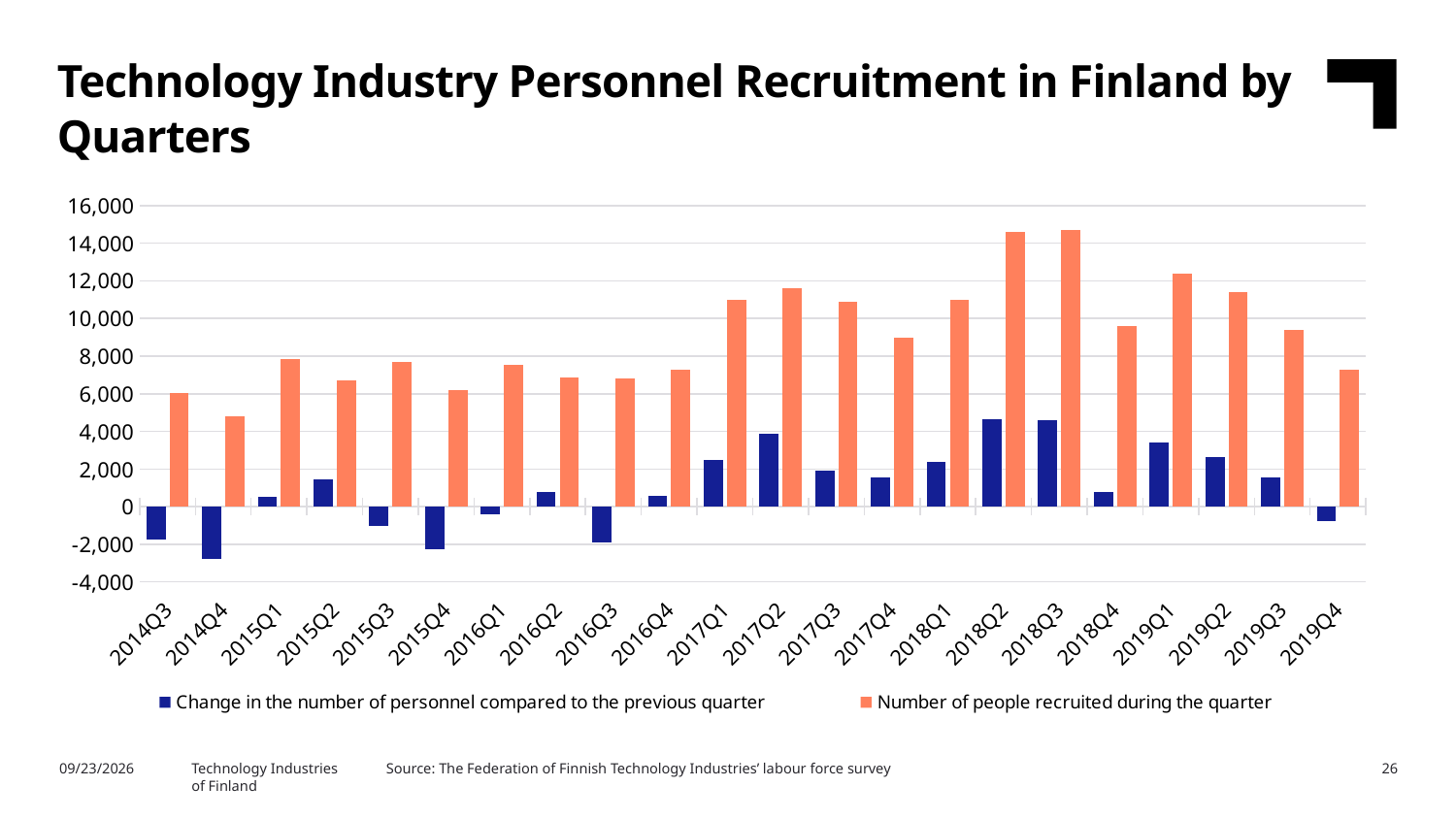
Is the change in the number of personnel in 2016Q3 greater or less than 0? less What kind of chart is shown on the slide? Bar chart How many quarters are shown on the x axis? 22 Is the number of people recruited in 2017Q1 greater or less than 10,000? greater How many series does the legend list? 2 Which quarter has the lowest number of people recruited during the quarter? 2014Q4 Is the change in the number of personnel in 2017Q2 greater or less than 2,000? greater Does the number of people recruited rise or fall from 2019Q1 to 2019Q4? Fall What colour are the bars for the number of people recruited during the quarter? Orange Which quarter had more people recruited, 2019Q1 or 2019Q2? 2019Q1 Which quarter has the lowest change in the number of personnel compared to the previous quarter? 2014Q4